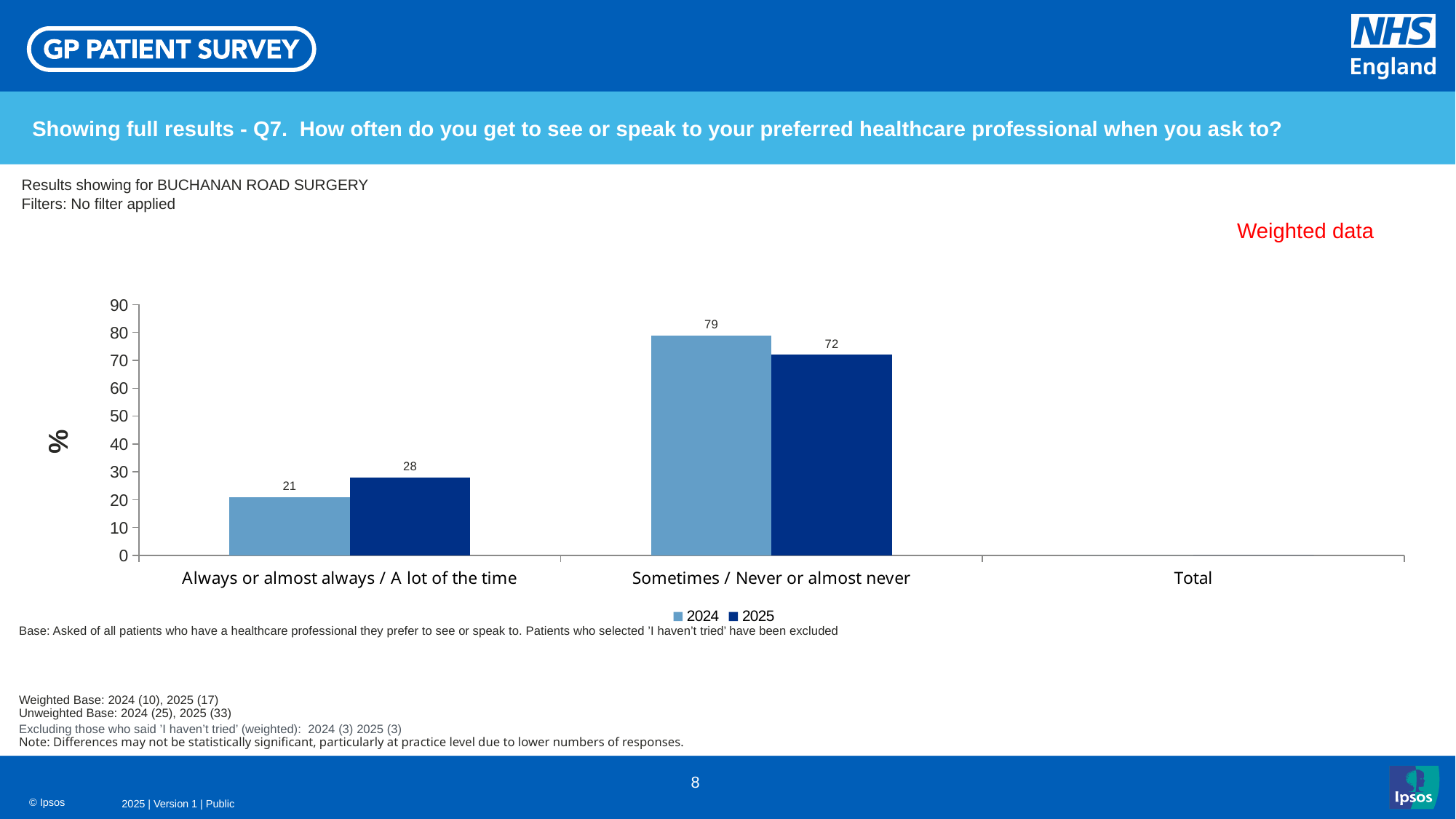
What is the label on the vertical axis of the chart? % What is the 2024 value for 'Sometimes / Never or almost never'? 79 What is the 2025 value for 'Always or almost always / A lot of the time'? 28 Which is larger for 'Always or almost always / A lot of the time': the 2024 value or the 2025 value? 2025 What kind of chart is shown on the slide? Bar chart How many series does the legend list? 2 What is the difference between the 2025 and 2024 values for 'Always or almost always / A lot of the time'? 7 What is the 2024 value for 'Always or almost always / A lot of the time'? 21 What is the 2025 value for 'Sometimes / Never or almost never'? 72 Is the 2024 value for 'Sometimes / Never or almost never' greater or less than 70? greater Which category has the highest 2024 value? Sometimes / Never or almost never What is the difference between the 2024 and 2025 values for 'Sometimes / Never or almost never'? 7